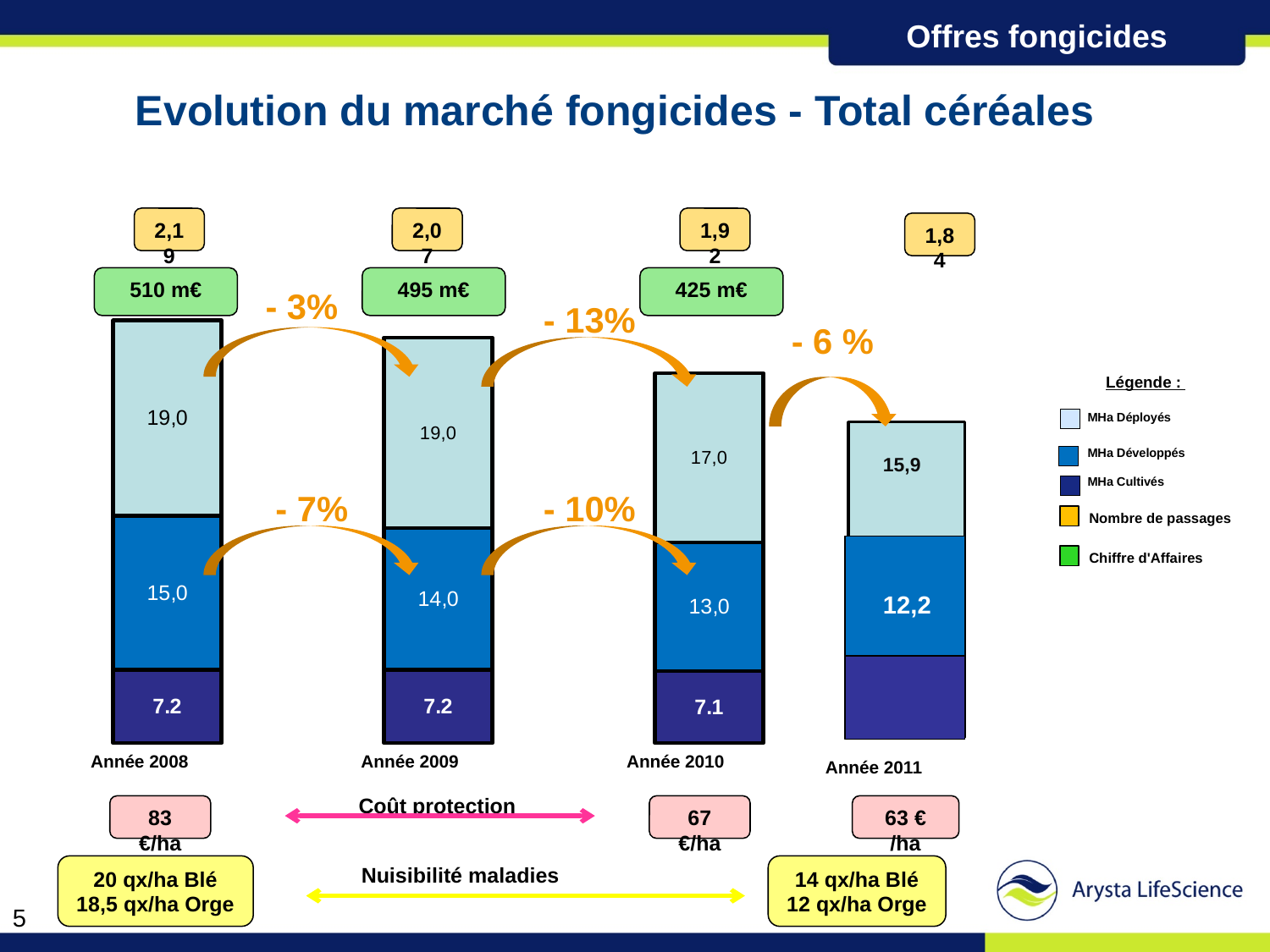
What kind of chart is shown on the slide? Stacked bar chart Which year has the larger MHa Déployés value, Année 2009 or Année 2011? Année 2009 What is the difference between the Chiffre d'Affaires for Année 2008 and Année 2010? 85 m€ How many years are shown on the chart? 4 What is the value of MHa Déployés for Année 2010? 17,0 Which year has the lowest value for MHa Développés? Année 2011 What is the difference between the MHa Développés values for Année 2008 and Année 2010? 2,0 How many entries does the legend list? 5 What is the Chiffre d'Affaires shown for Année 2009? 495 m€ What is the value of MHa Cultivés for Année 2010? 7.1 Do the MHa Développés values rise or fall from Année 2008 to Année 2011? Fall What is the value of MHa Développés for Année 2011? 12,2